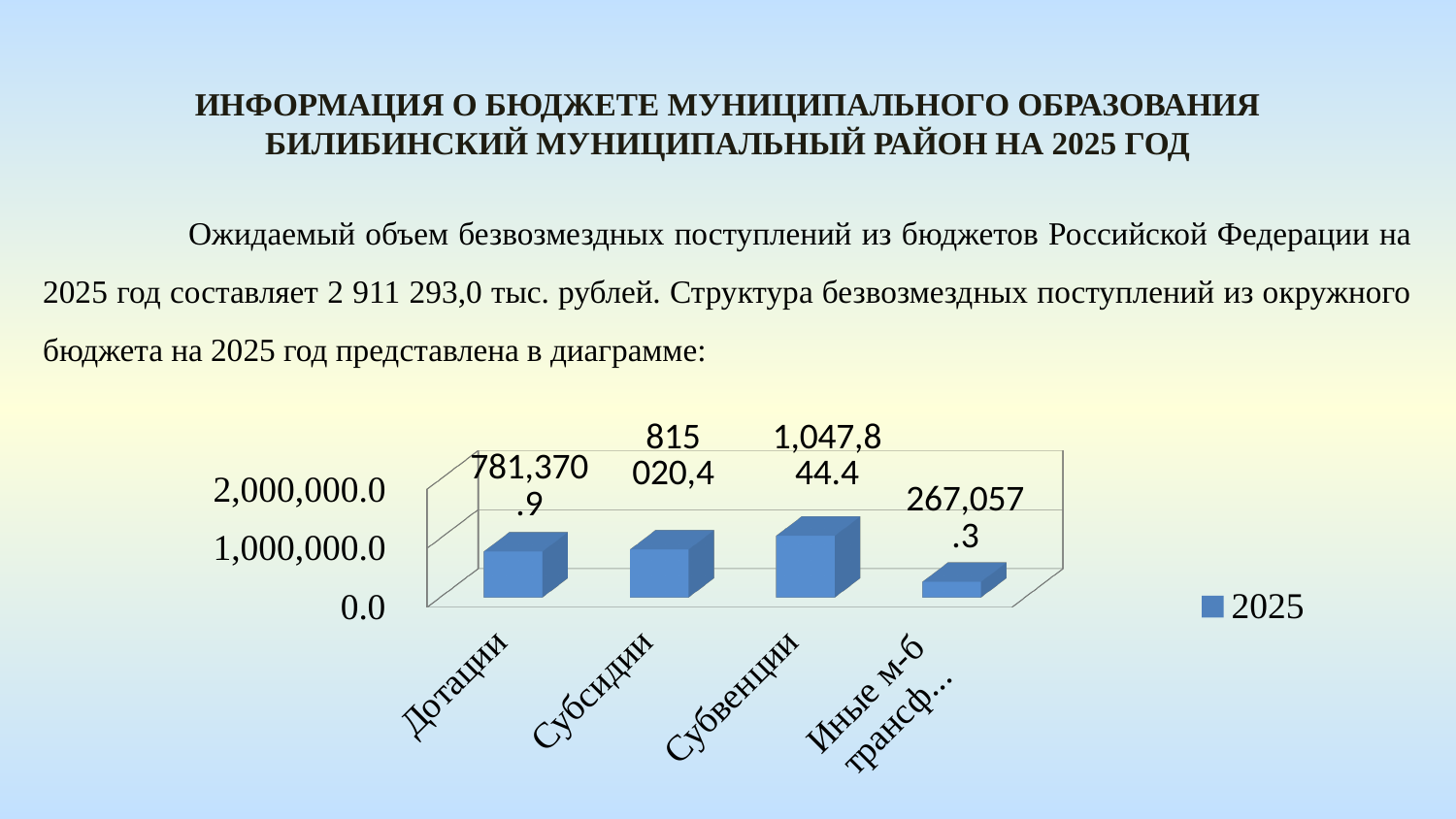
What kind of chart is shown on the slide? bar chart Which category has the lowest value? Иные м-б трансф... Is the value for Субвенции greater or less than 1,000,000.0? greater What is the value for Дотации? 781,370.9 What is the value for Субвенции? 1,047,844.4 Is the value for Дотации greater or less than 1,000,000.0? less How many categories are shown on the x axis? 4 How many series does the legend list? 1 What is the difference between the values for Субвенции and Дотации? 266,473.5 What is the value for Субсидии? 815 020,4 Which category has the highest value? Субвенции Which is larger, the value for Дотации or the value for Субсидии? Субсидии